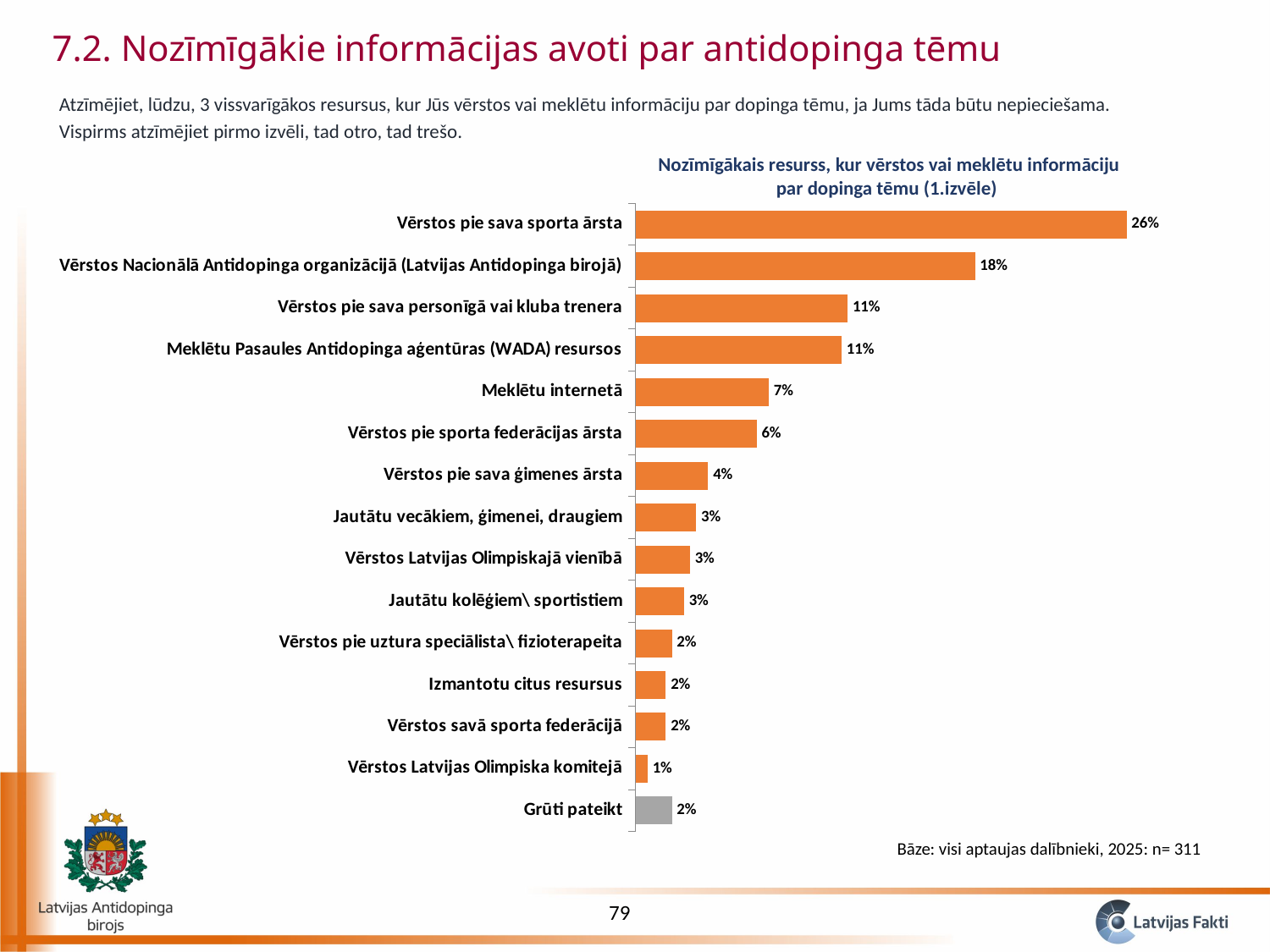
What is the value shown for "Meklētu internetā"? 7% What is the value shown for "Grūti pateikt"? 2% Which category has the highest value in the chart? Vērstos pie sava sporta ārsta How many categories are shown in the chart? 15 Which category has the lowest value in the chart? Vērstos Latvijas Olimpiska komitejā What is the value shown for "Vērstos pie sava ģimenes ārsta"? 4% What is the title of the chart? Nozīmīgākais resurss, kur vērstos vai meklētu informāciju par dopinga tēmu (1.izvēle) What percentage of respondents chose "Vērstos pie sava sporta ārsta" as their first choice? 26% Which is larger: the value for "Vērstos pie sava personīgā vai kluba trenera" or the value for "Meklētu internetā"? Vērstos pie sava personīgā vai kluba trenera What is the difference between the values for "Meklētu internetā" and "Vērstos pie sporta federācijas ārsta"? 1% What type of chart is shown on the slide? Bar chart What is the difference between the values for "Vērstos pie sava sporta ārsta" and "Vērstos Nacionālā Antidopinga organizācijā (Latvijas Antidopinga birojā)"? 8%